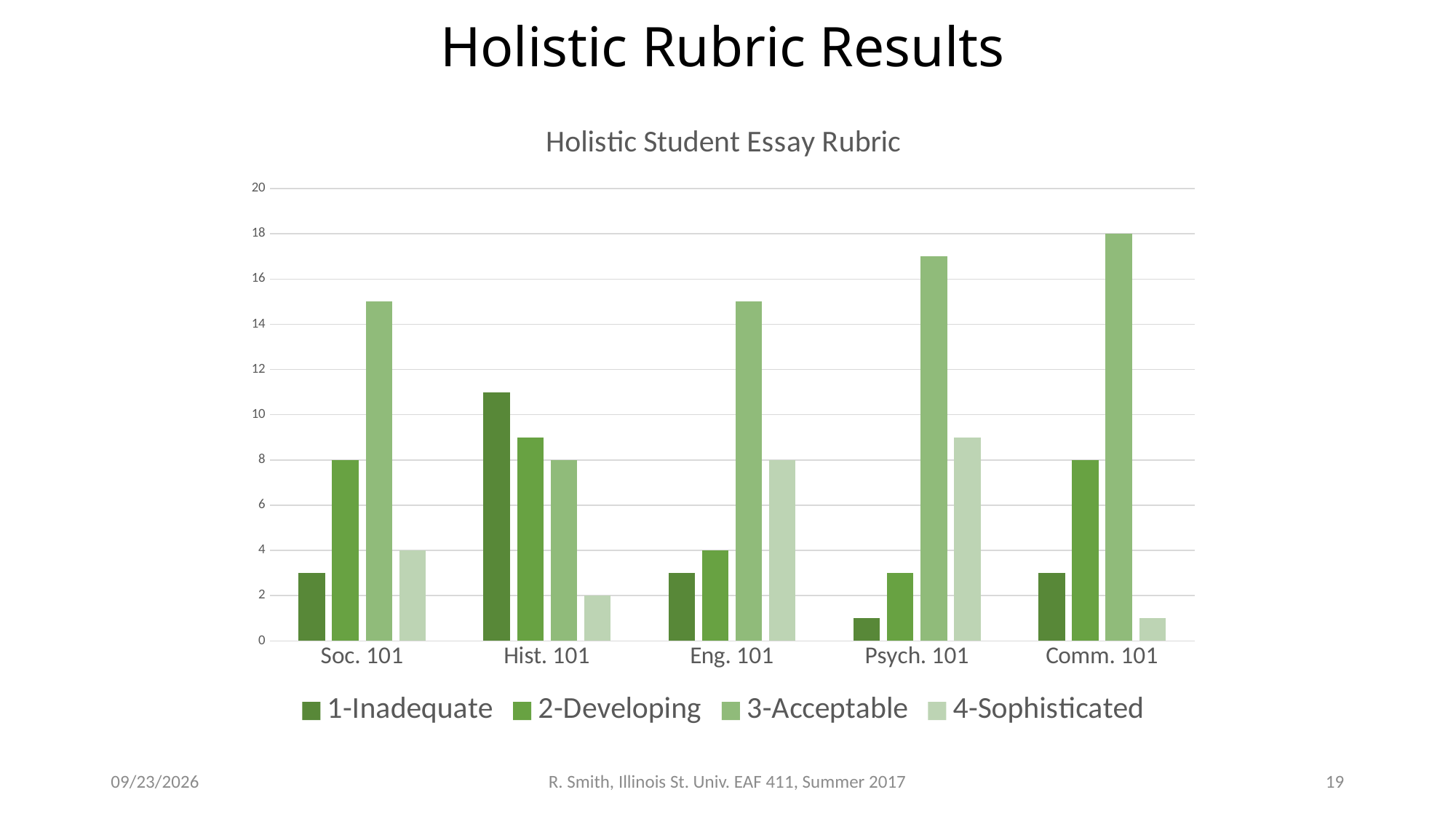
What is the value for 2-Developing in Soc. 101? 8 Is the value for 1-Inadequate in Hist. 101 greater or less than 10? greater How many series does the legend list? 4 What is the difference between the 3-Acceptable and 2-Developing values in Comm. 101? 10 What is the value for 4-Sophisticated in Hist. 101? 2 What kind of chart is shown on the slide? bar chart How many course categories are shown on the x axis? 5 Which course has the highest 3-Acceptable value? Comm. 101 What is the value for 3-Acceptable in Comm. 101? 18 What is the title of the chart? Holistic Student Essay Rubric Which is larger, the 3-Acceptable value for Psych. 101 or for Eng. 101? Psych. 101 Which course has the highest 1-Inadequate value? Hist. 101